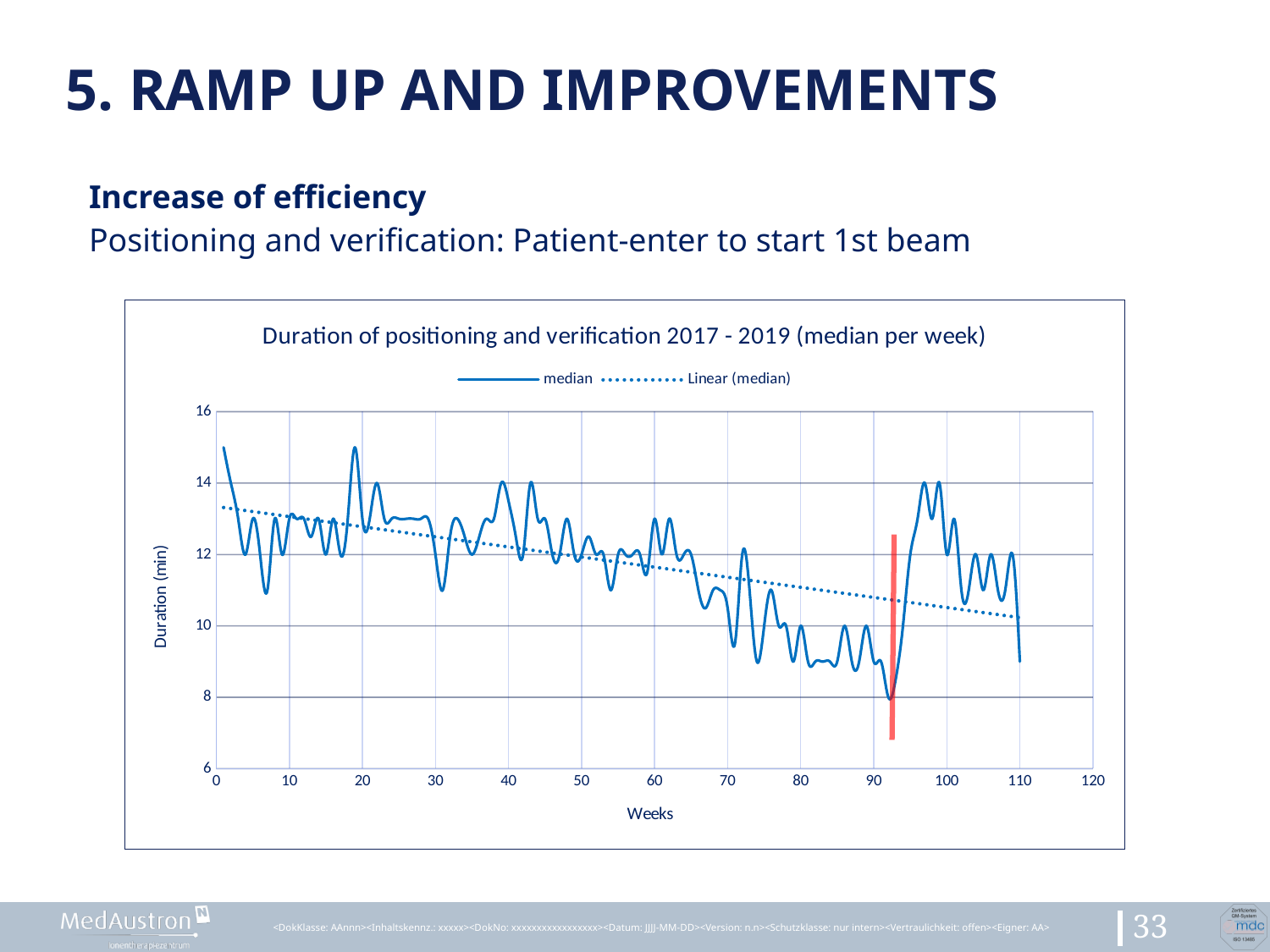
What is the title of the chart? Duration of positioning and verification 2017 - 2019 (median per week) Is the median value at week 19 greater or less than 14? greater What is the label of the vertical axis of the chart? Duration (min) What kind of chart is shown on the slide? line chart Is the median value at week 110 greater or less than 10? less Overall, does the median duration rise or fall from week 0 to week 110? fall Is the median value at week 1 greater or less than 14? greater Does the dotted linear trendline rise or fall as the weeks increase? fall Which is larger, the median value at week 1 or the median value at week 92? week 1 How many series does the chart legend list? 2